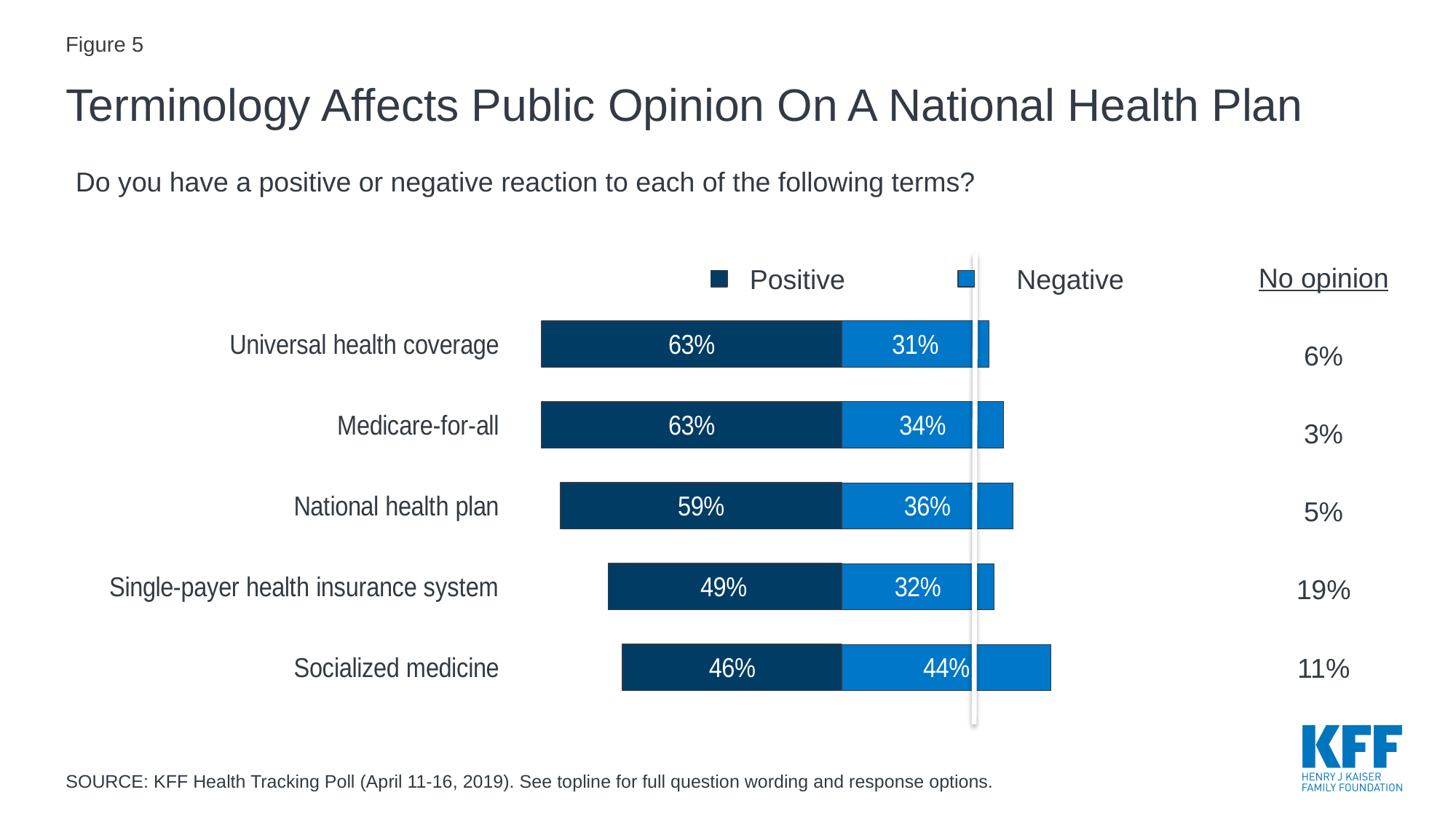
Which term has the lowest positive reaction percentage? Socialized medicine How many terms are shown in the chart? 5 What is the difference between the positive and negative percentages for "National health plan"? 23 percentage points Which has a higher negative reaction percentage, "Universal health coverage" or "Medicare-for-all"? Medicare-for-all How many series does the legend list? 2 What is the combined positive and negative percentage for "Single-payer health insurance system"? 81% What is the "No opinion" percentage for "Single-payer health insurance system"? 19% What percentage of respondents had a negative reaction to the term "Socialized medicine"? 44% Which term has the highest negative reaction percentage? Socialized medicine Which term has the highest "No opinion" percentage? Single-payer health insurance system What kind of chart is shown on the slide? Stacked horizontal bar chart What percentage of respondents had a positive reaction to the term "Medicare-for-all"? 63%